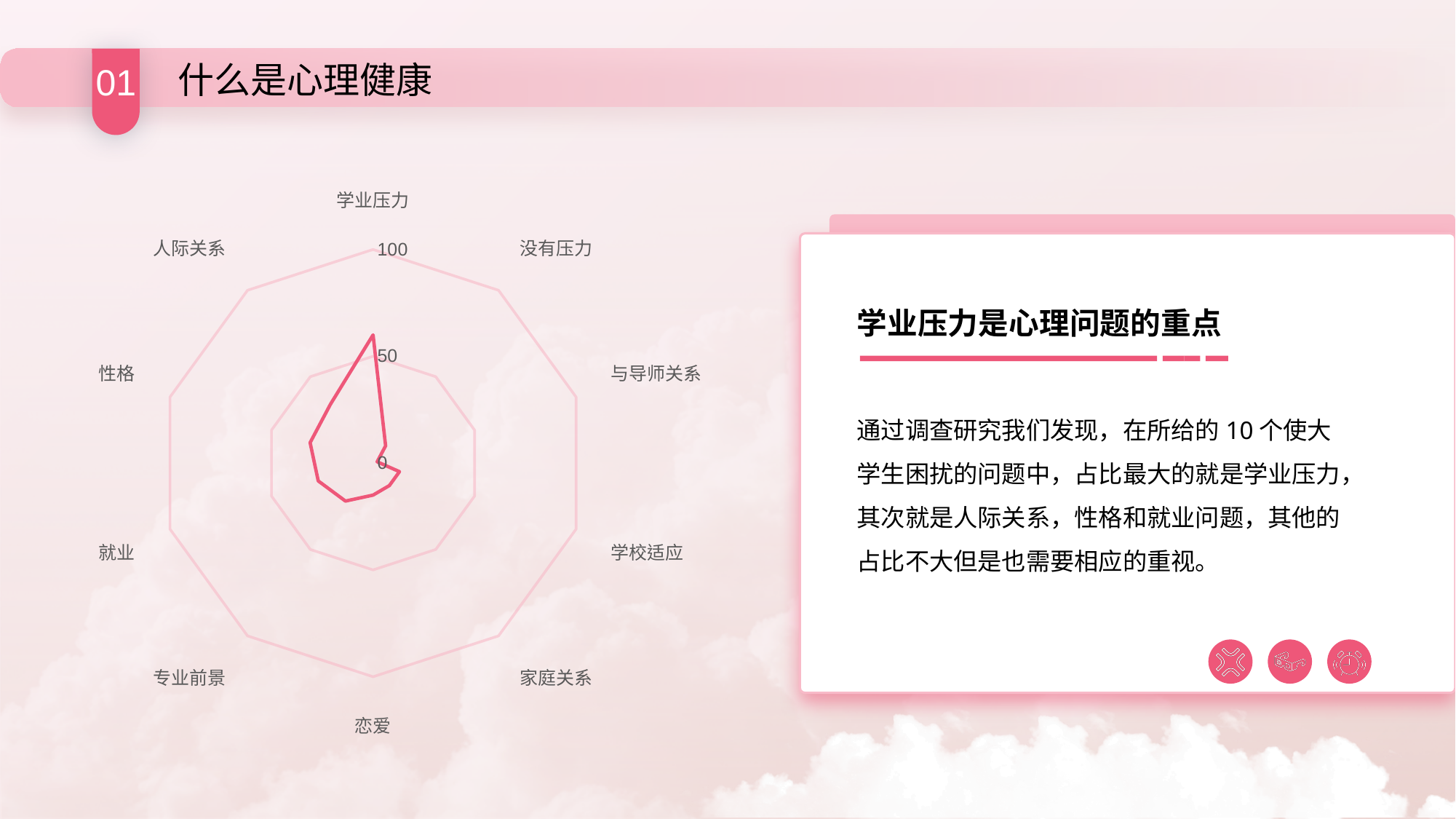
What is the maximum value shown on the radar chart's axis scale? 100 Which is larger, the value for 学业压力 or the value for 恋爱? 学业压力 Is the value for 学业压力 greater or less than 50? greater Which is larger, the value for 学业压力 or the value for 就业? 学业压力 Which category label appears at the top of the radar chart? 学业压力 Which is larger, the value for 人际关系 or the value for 家庭关系? 人际关系 Is the value for 人际关系 greater or less than 50? less How many categories does the radar chart have? 10 Is the value for 学业压力 greater or less than 100? less Which category has the highest value in the radar chart? 学业压力 What kind of chart is shown on the slide? radar chart